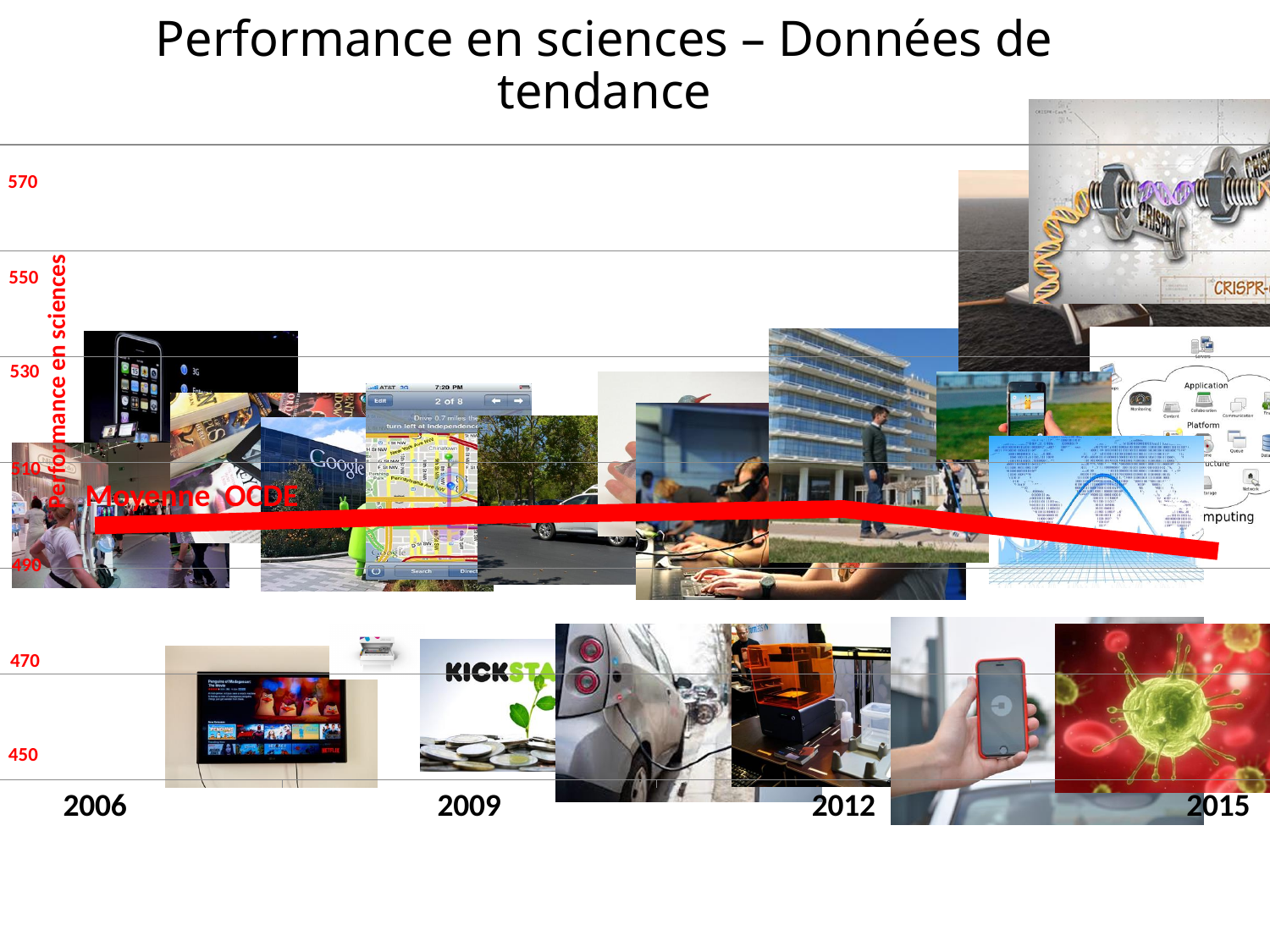
Which is larger, the Moyenne OCDE value for 2012 or for 2015? 2012 Is the Moyenne OCDE value for 2006 greater or less than 490? greater Is the Moyenne OCDE value for 2012 greater or less than 470? greater What is the name of the series plotted by the red line? Moyenne OCDE What is the first year labelled on the x axis? 2006 How many series does the chart plot? 1 How many years are labelled on the x axis? 4 Does the Moyenne OCDE line rise or fall between 2012 and 2015? fall What is the highest value labelled on the y axis? 570 Is the Moyenne OCDE value for 2015 greater or less than 530? less What kind of chart is shown on the slide? line chart